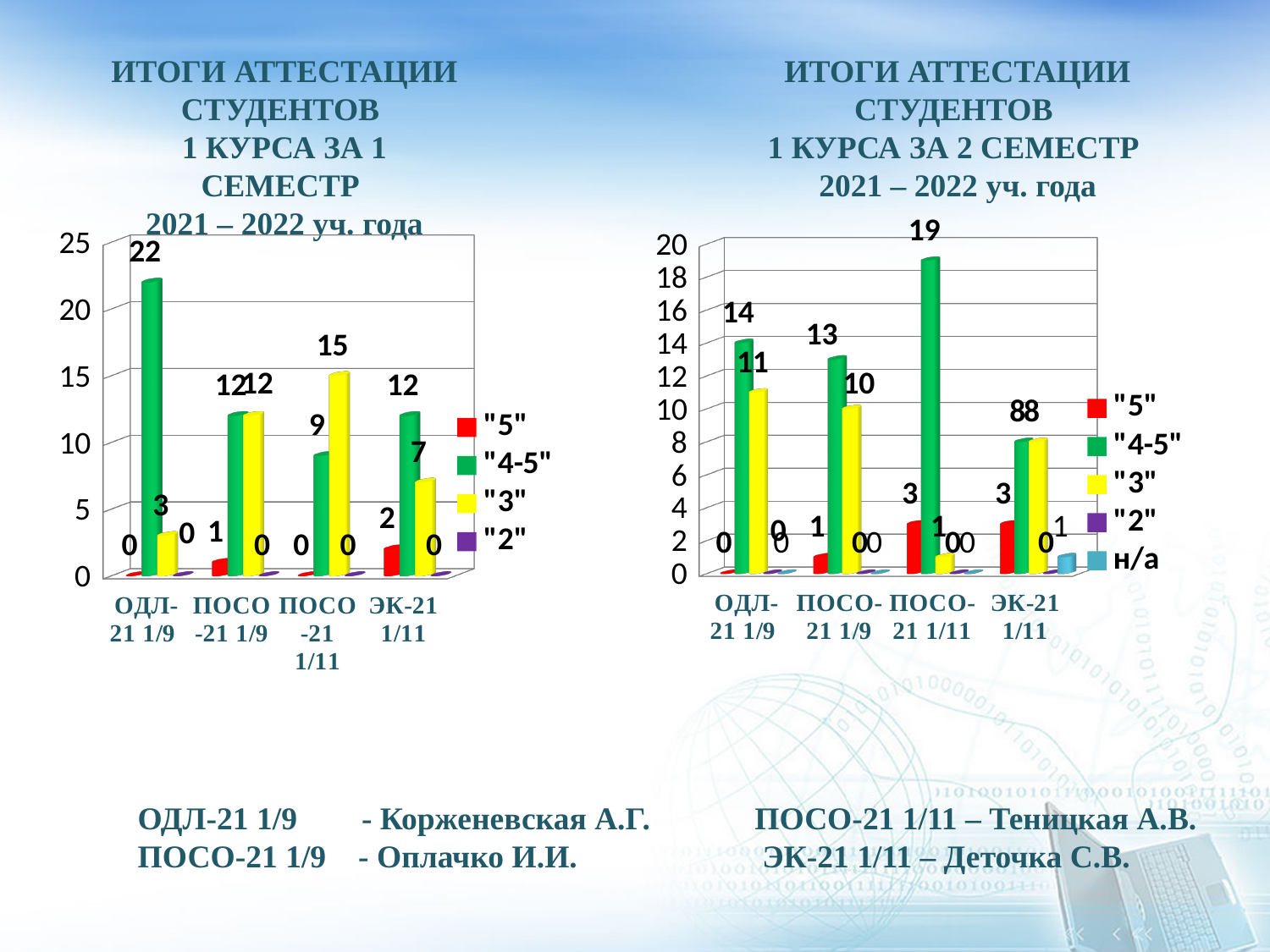
In the right chart (2 семестр), which group has the lowest "3" value? ПОСО-21 1/11 In the right chart (2 семестр), what is the value of "4-5" for ПОСО-21 1/11? 19 In the right chart (2 семестр), what is the value of "5" for ЭК-21 1/11? 3 In the left chart (1 семестр), what is the difference between the "3" values for ПОСО-21 1/11 and ЭК-21 1/11? 8 What type of chart is the left chart (1 семестр)? Bar chart How many groups (categories) are shown on the x axis of the right chart (2 семестр)? 4 In the left chart (1 семестр), which group has the highest "4-5" value? ОДЛ-21 1/9 In the left chart (1 семестр), what is the value of "3" for ПОСО-21 1/11? 15 In the left chart (1 семестр), how many series does the legend list? 4 In the left chart (1 семестр), what is the value of "4-5" for ОДЛ-21 1/9? 22 In the right chart (2 семестр), which is larger for ОДЛ-21 1/9: the "4-5" value or the "3" value? "4-5" In the right chart (2 семестр), how many series does the legend list? 5